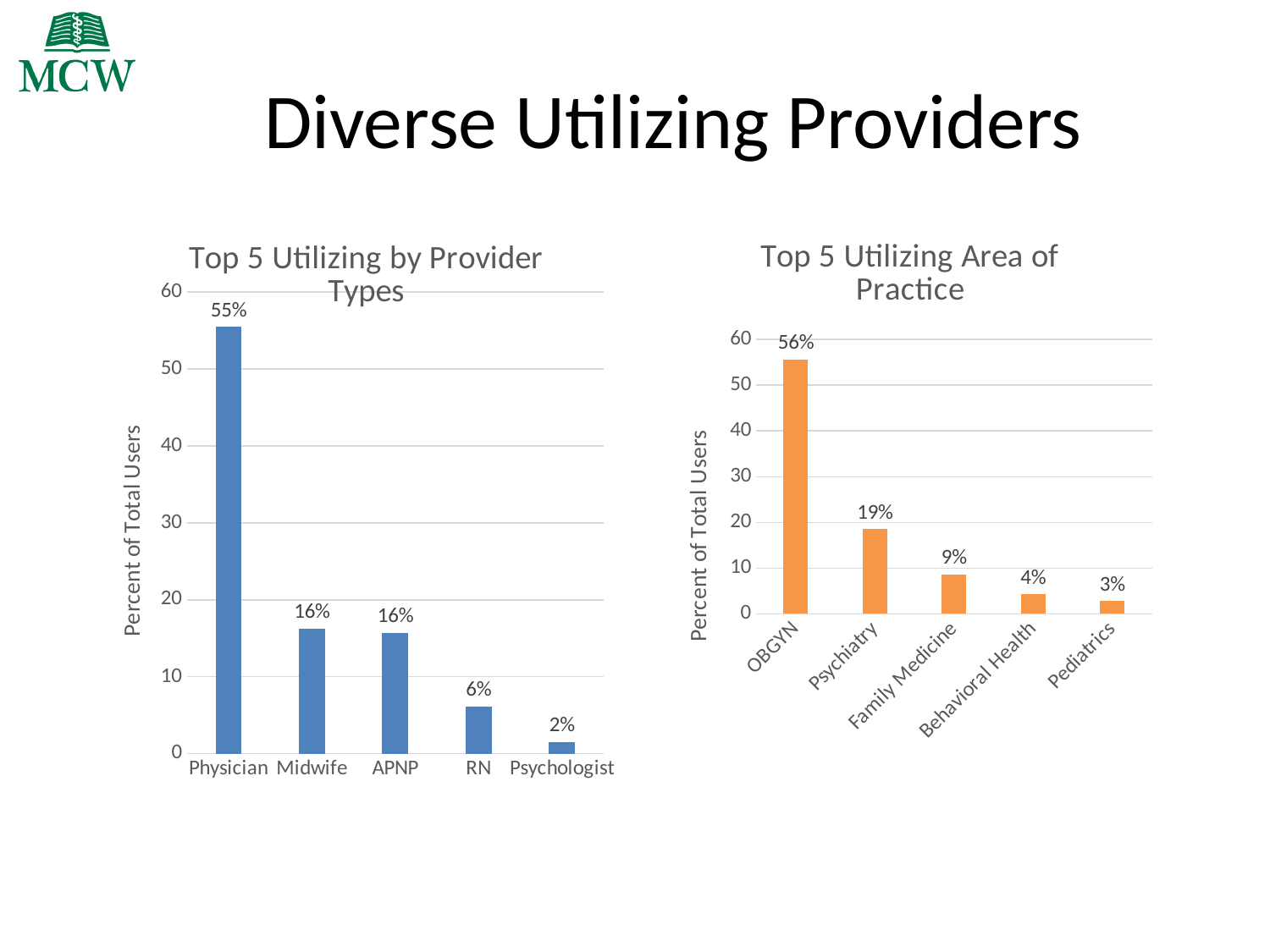
In the 'Top 5 Utilizing Area of Practice' chart, what is the value for Pediatrics? 3% In the 'Top 5 Utilizing by Provider Types' chart, what is the value for RN? 6% In the 'Top 5 Utilizing Area of Practice' chart, which is larger, Family Medicine or Behavioral Health? Family Medicine In the 'Top 5 Utilizing by Provider Types' chart, which provider type has the lowest value? Psychologist In the 'Top 5 Utilizing by Provider Types' chart, how many provider types are shown? 5 In the 'Top 5 Utilizing by Provider Types' chart, what is the difference between the Physician and Midwife values? 39% What kind of chart is the 'Top 5 Utilizing Area of Practice' chart? Bar chart What is the y-axis label on the 'Top 5 Utilizing by Provider Types' chart? Percent of Total Users In the 'Top 5 Utilizing Area of Practice' chart, what is the value for Psychiatry? 19% In the 'Top 5 Utilizing Area of Practice' chart, what is the difference between the Psychiatry and Family Medicine values? 10% In the 'Top 5 Utilizing by Provider Types' chart, what is the value for Physician? 55% In the 'Top 5 Utilizing Area of Practice' chart, which area of practice has the highest value? OBGYN